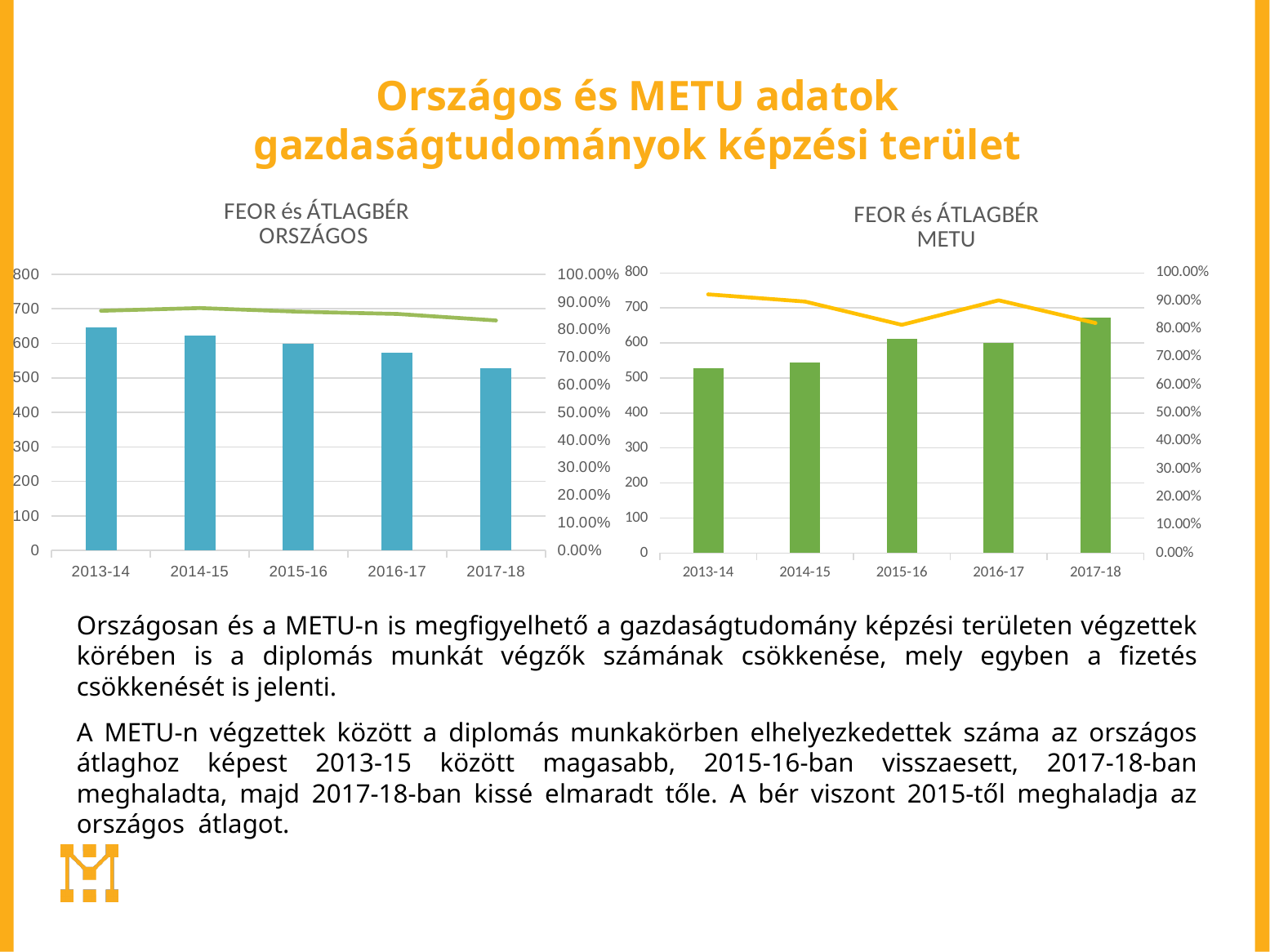
In the FEOR és ÁTLAGBÉR METU chart, is the line value for 2015-16 greater or less than 90.00%? less In the FEOR és ÁTLAGBÉR METU chart, which year has the tallest bar? 2017-18 In the FEOR és ÁTLAGBÉR ORSZÁGOS chart, which year has the shortest bar? 2017-18 In the FEOR és ÁTLAGBÉR METU chart, is the bar value for 2017-18 greater or less than 600? greater In the FEOR és ÁTLAGBÉR ORSZÁGOS chart, which year has the tallest bar? 2013-14 In the FEOR és ÁTLAGBÉR METU chart, which year has the shortest bar? 2013-14 In the FEOR és ÁTLAGBÉR METU chart, which bar is taller, 2013-14 or 2015-16? 2015-16 In the FEOR és ÁTLAGBÉR ORSZÁGOS chart, what kind of chart is used for the yearly values? A bar chart combined with a line In the FEOR és ÁTLAGBÉR ORSZÁGOS chart, how many academic years are shown on the x axis? 5 In the FEOR és ÁTLAGBÉR ORSZÁGOS chart, do the bar values rise or fall from 2013-14 to 2017-18? Fall What colour are the bars in the FEOR és ÁTLAGBÉR METU chart? Green In the FEOR és ÁTLAGBÉR ORSZÁGOS chart, is the bar value for 2017-18 greater or less than 600? less